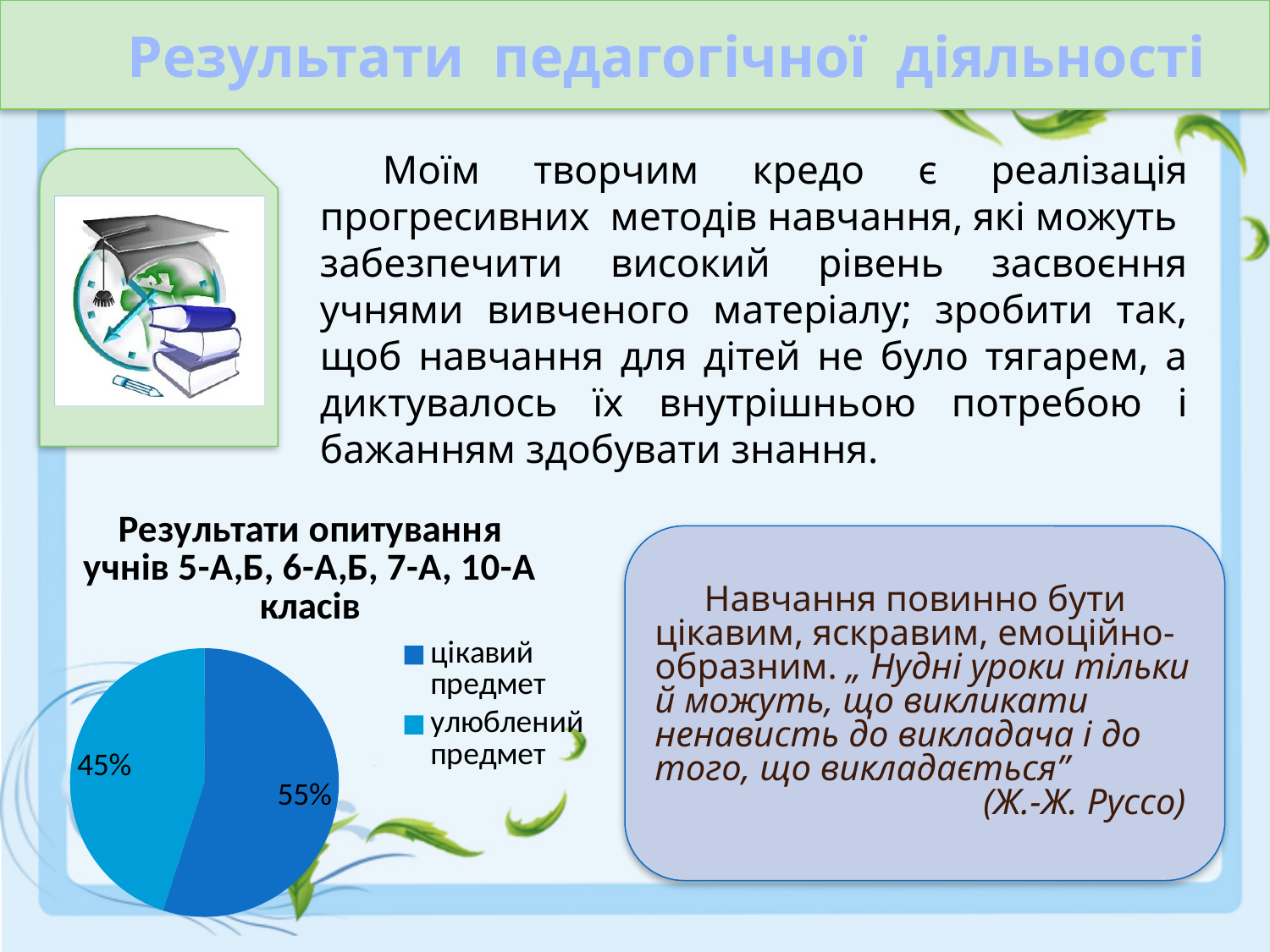
What share of the pie does "улюблений предмет" take? 45% What kind of chart is shown on the slide? pie chart Which slice of the pie chart is the smallest? улюблений предмет How many slices does the pie chart have? 2 What is the difference between the shares for "цікавий предмет" and "улюблений предмет"? 10% Which legend entry is shown in the lighter blue colour? улюблений предмет How many entries does the legend of the pie chart list? 2 What is the title of the pie chart? Результати опитування учнів 5-А,Б, 6-А,Б, 7-А, 10-А класів What share of the pie does "цікавий предмет" take? 55% Which slice of the pie chart is the largest? цікавий предмет Which is larger: the share for "цікавий предмет" or for "улюблений предмет"? цікавий предмет